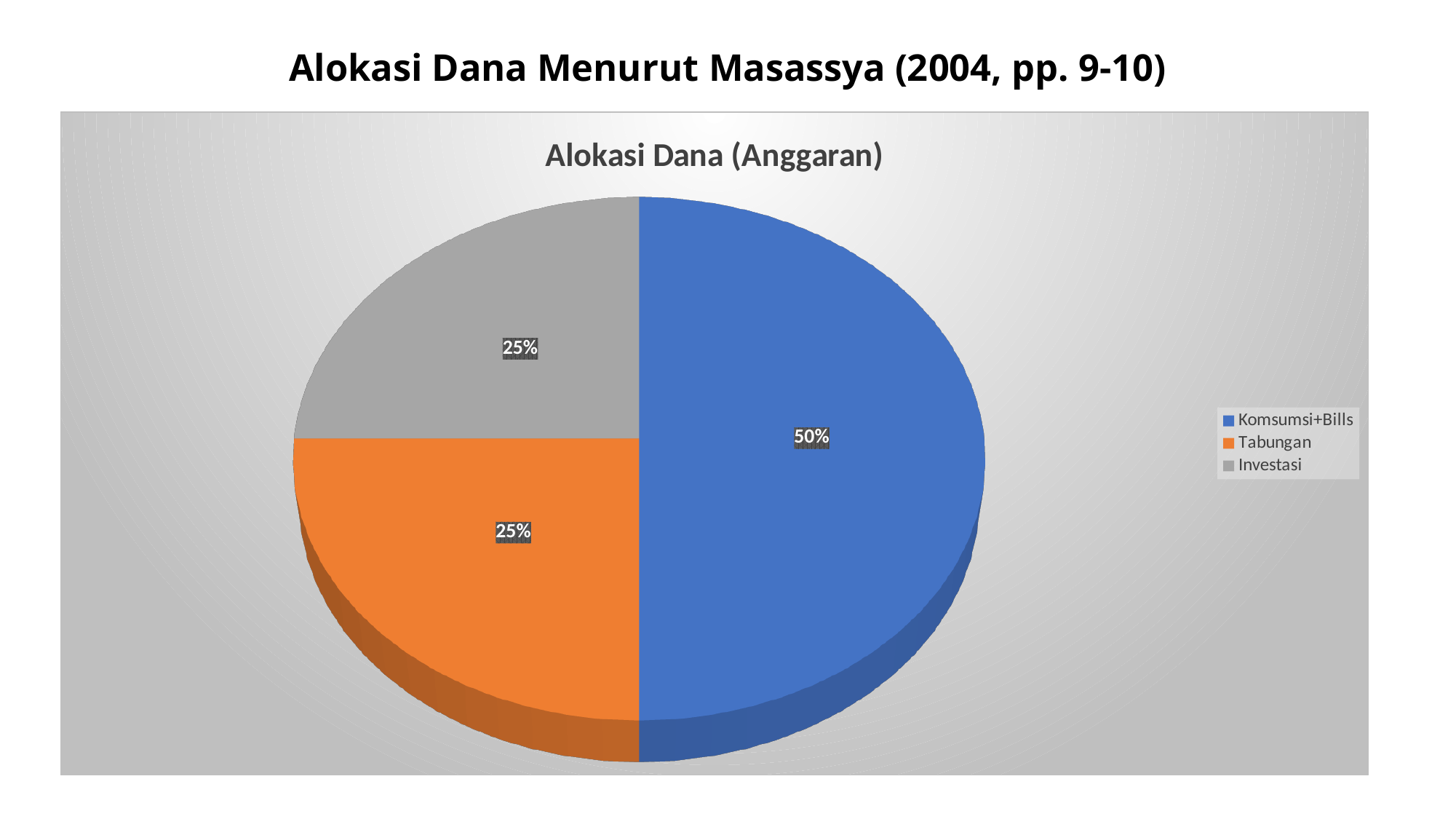
Which is larger, the share for Komsumsi+Bills or the share for Investasi? Komsumsi+Bills What share of the pie does Investasi take? 25% How many slices does the pie chart have? 3 What share of the pie does Komsumsi+Bills take? 50% What colour is the Tabungan slice? Orange Which category has the largest slice of the pie? Komsumsi+Bills What type of chart is shown on the slide? Pie chart What is the difference between the Komsumsi+Bills share and the Tabungan share? 25% How many entries does the legend list? 3 What is the combined share of Tabungan and Investasi? 50% What share of the pie does Tabungan take? 25% What is the chart's title? Alokasi Dana (Anggaran)